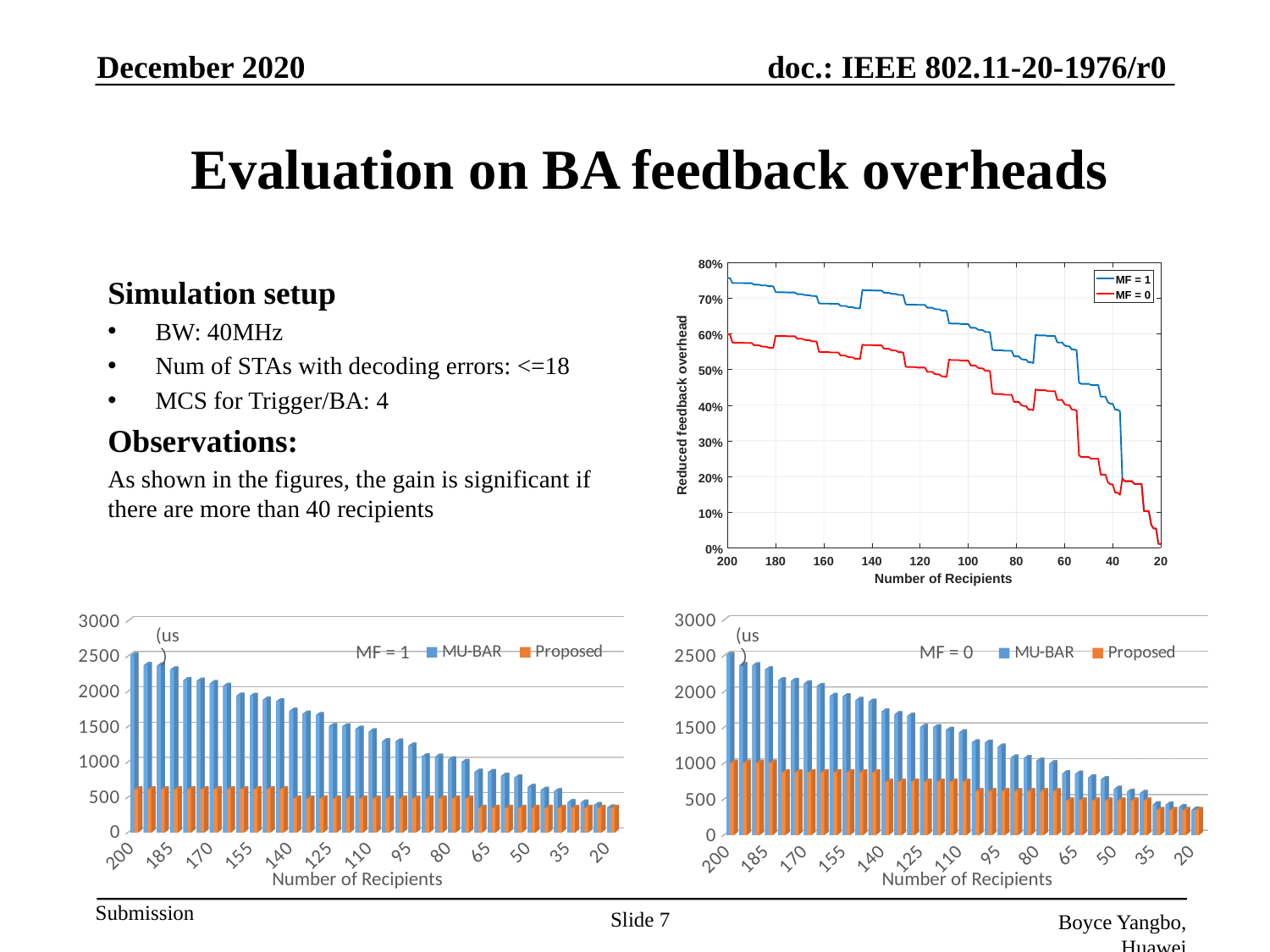
What kind of chart is the top-right chart titled 'Reduced feedback overhead'? line chart In the bottom-left 'MF = 1' bar chart, how many series does the legend list? 2 In the top-right line chart, is the MF = 1 value at 200 recipients greater or less than 70%? greater In the top-right line chart, do the values rise or fall moving from left (200 recipients) to right (20 recipients) along the x axis? fall In the top-right line chart, how many series does the legend list? 2 In the bottom-right 'MF = 0' bar chart, at which number of recipients is the MU-BAR value highest? 200 In the bottom-right 'MF = 0' bar chart, is the Proposed value at 200 recipients greater or less than 500? greater In the top-right line chart, is the MF = 0 value at 200 recipients greater or less than 50%? greater What kind of chart is the bottom-left chart labelled 'MF = 1'? bar chart In the top-right line chart, which series has the higher value at 200 recipients, MF = 1 or MF = 0? MF = 1 In the bottom-left 'MF = 1' bar chart, which series is larger at 200 recipients, MU-BAR or Proposed? MU-BAR